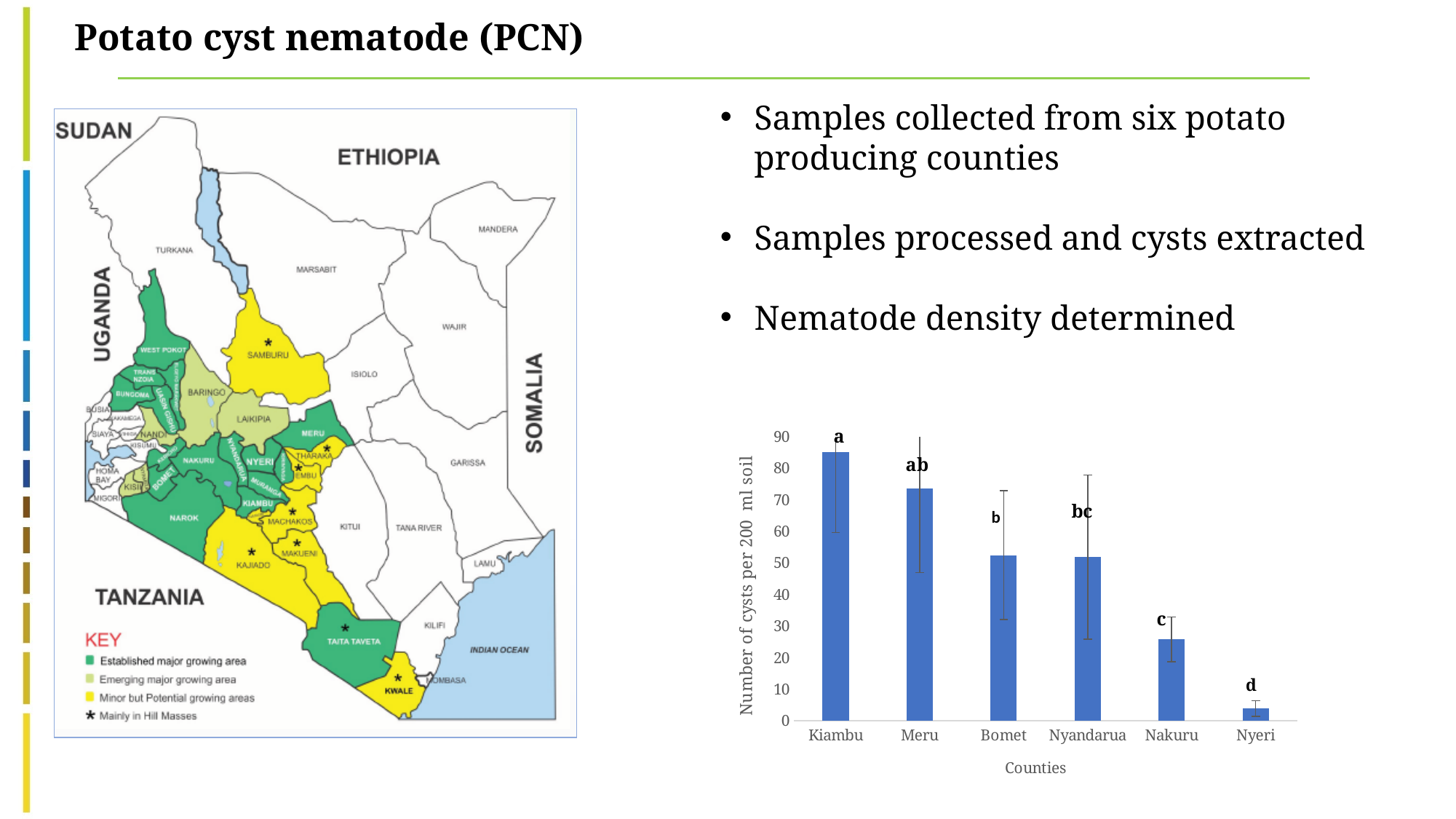
Do the bar values rise or fall from Kiambu to Nyeri along the x axis? fall Is the value for Nakuru greater or less than 30? less What kind of chart is shown on the slide? bar chart Which county has a higher number of cysts, Kiambu or Meru? Kiambu Which county has the highest number of cysts per 200 ml soil? Kiambu Is the value for Meru greater or less than 70? greater Is the value for Nyeri greater or less than 10? less How many counties are shown on the x axis of the bar chart? 6 What is the label of the y axis of the bar chart? Number of cysts per 200 ml soil Which county has the lowest number of cysts per 200 ml soil? Nyeri